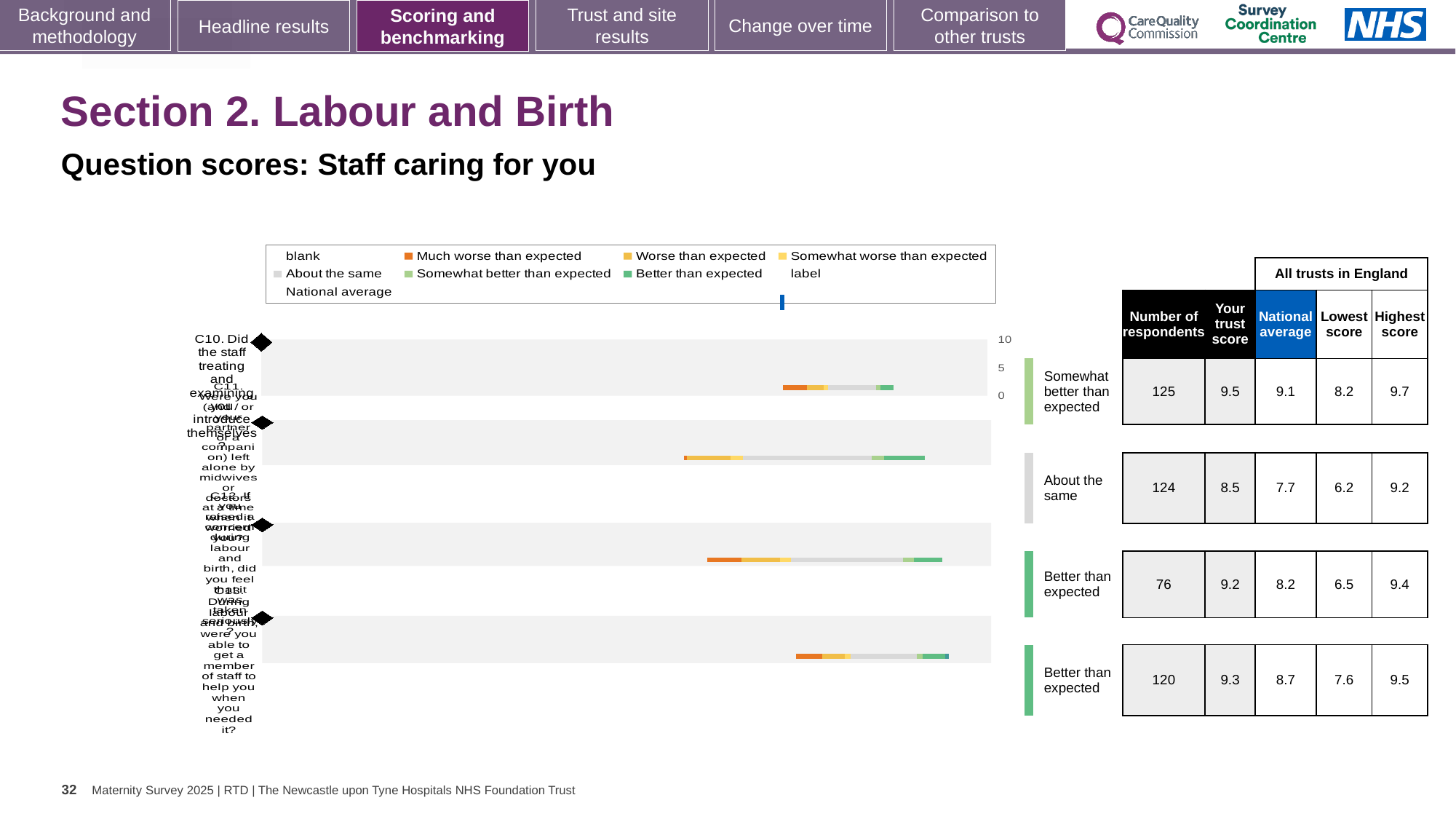
In the table, what is the trust score for the second row (C11)? 8.5 Which row has the lowest number of respondents in the table? the third row (C12), 76 In the table, what is the highest score for the fourth row (C13)? 9.5 For the second row (C11), which is larger: the trust score or the national average? the trust score (8.5) In the table, what is the number of respondents for the first row (C10)? 125 In the table, what is the lowest score for the second row (C11)? 6.2 Which row has the highest trust score in the table? the first row (C10), 9.5 What is the difference between the trust score and the national average for the first row (C10)? 0.4 In the table, what is the national average for the third row (C12)? 8.2 How many question rows (categories) are plotted in the chart? 4 What kind of chart is shown on the slide? bar chart What benchmark category is shown for the second row (C11)? About the same